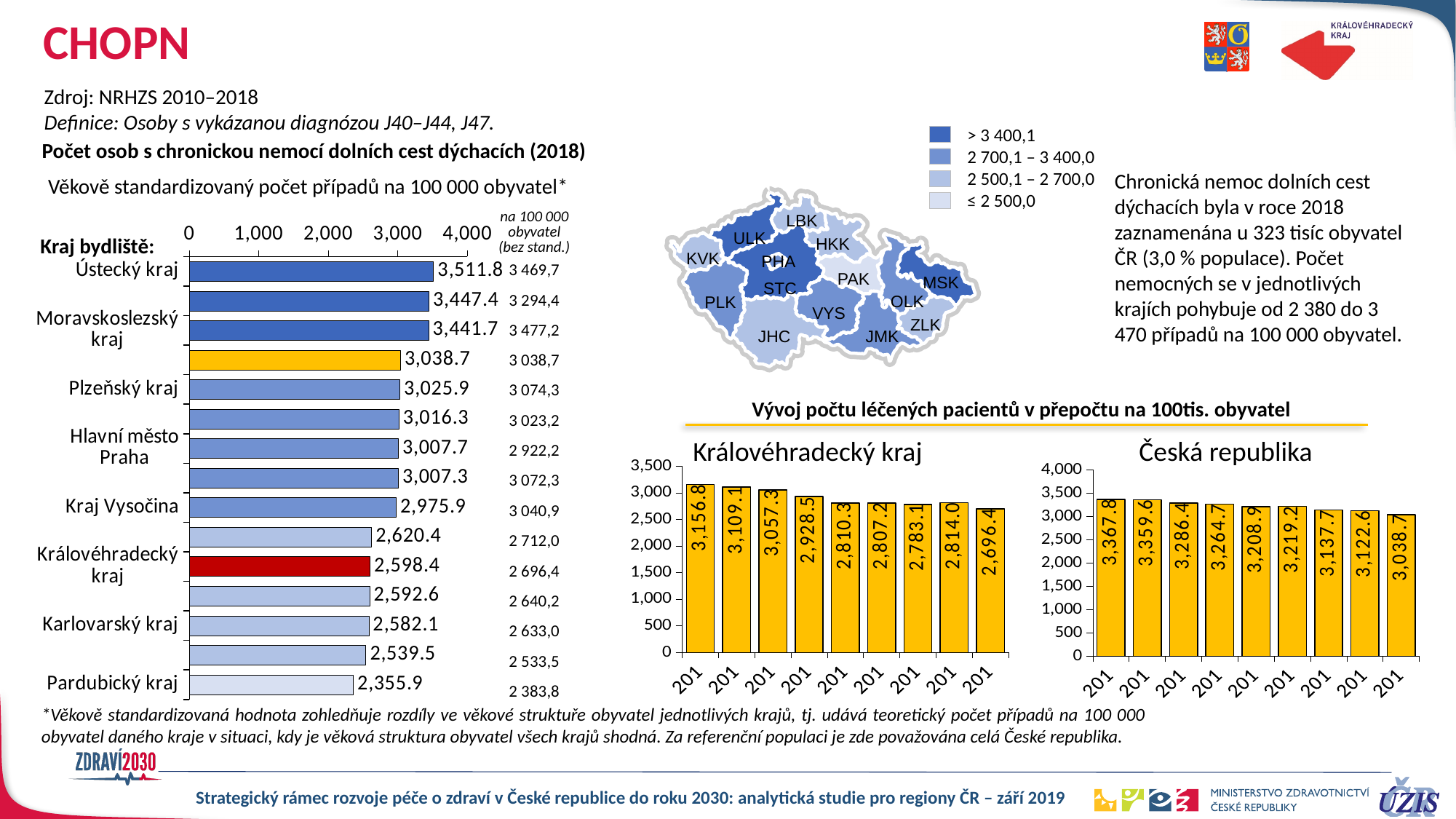
In the left chart of age-standardized cases per 100,000 inhabitants, what is the value for Pardubický kraj? 2,355.9 In the 'Česká republika' chart, what is the highest value shown? 3,367.8 In the left chart of age-standardized cases per 100,000 inhabitants, what is the value for Královéhradecký kraj? 2,598.4 In the 'Královéhradecký kraj' chart, what is the value of the first bar? 3,156.8 In the left chart of age-standardized cases per 100,000 inhabitants, what colour is the bar for Královéhradecký kraj? Red In the left chart of age-standardized cases per 100,000 inhabitants, which is larger: Plzeňský kraj or Kraj Vysočina? Plzeňský kraj How many bars are in the 'Česká republika' chart? 9 In the left chart of age-standardized cases per 100,000 inhabitants, what is the value for Ústecký kraj? 3,511.8 In the left chart of age-standardized cases per 100,000 inhabitants, what is the difference between Ústecký kraj and Pardubický kraj? 1,155.9 In the left chart of age-standardized cases per 100,000 inhabitants, which region has the lowest value? Pardubický kraj In the left chart of age-standardized cases per 100,000 inhabitants, which region has the highest value? Ústecký kraj In the 'Královéhradecký kraj' chart, what is the value of the last bar? 2,696.4